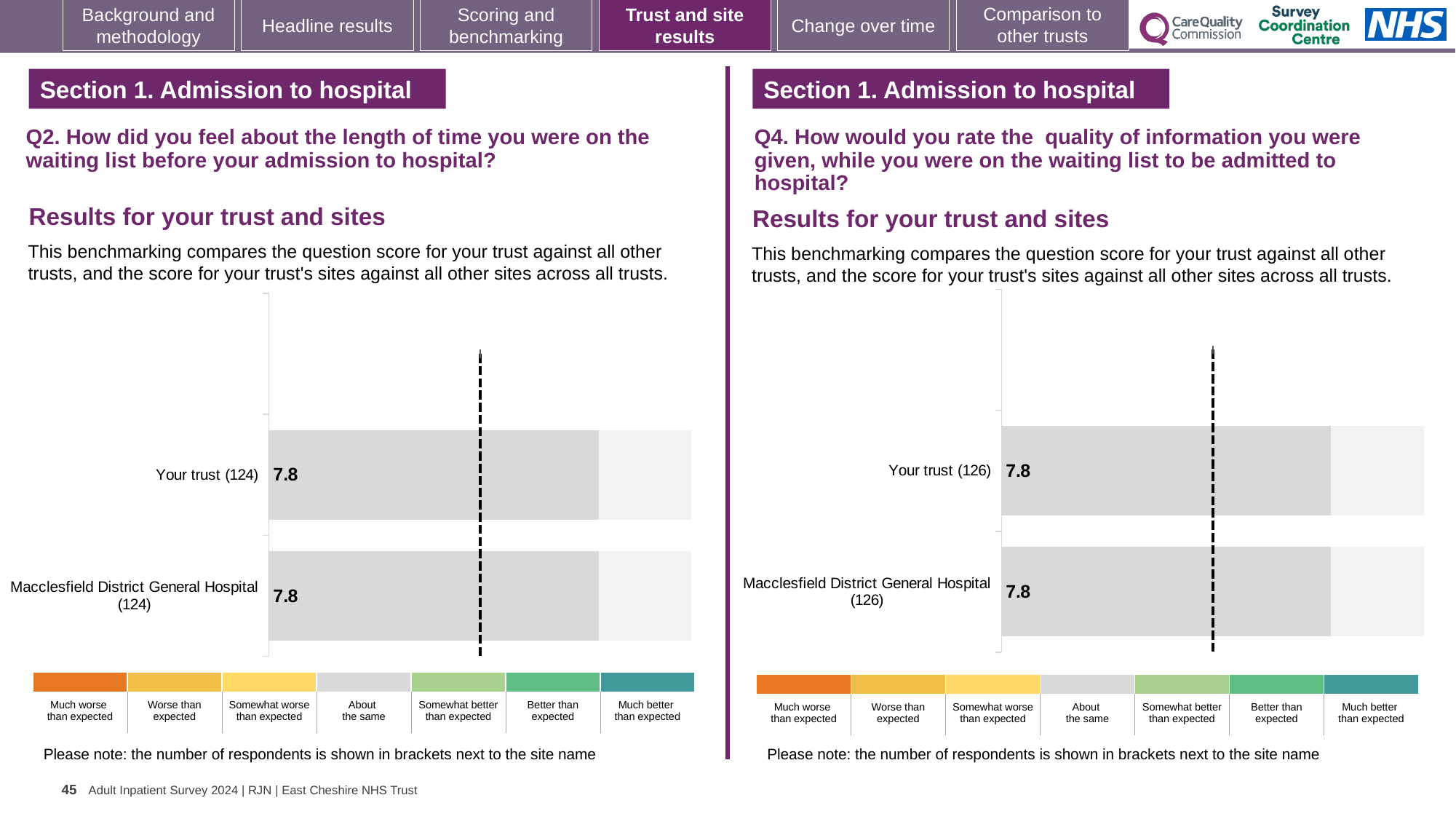
In the Q4 chart on the right, how many respondents are shown in brackets for Macclesfield District General Hospital? 126 In the Q4 chart on the right, what is the score for Macclesfield District General Hospital? 7.8 In the Q2 chart on the left, what is the score for Macclesfield District General Hospital? 7.8 What kind of chart is the Q2 chart on the left? Bar chart How many bars are plotted in the Q2 chart on the left? 2 In the Q2 chart on the left, what is the score for Your trust? 7.8 In the Q2 chart on the left, what is the difference between the score for Your trust and the score for Macclesfield District General Hospital? 0 In the Q4 chart on the right, what is the score for Your trust? 7.8 In the Q2 chart on the left, how many respondents are shown in brackets for Your trust? 124 How many bars are plotted in the Q4 chart on the right? 2